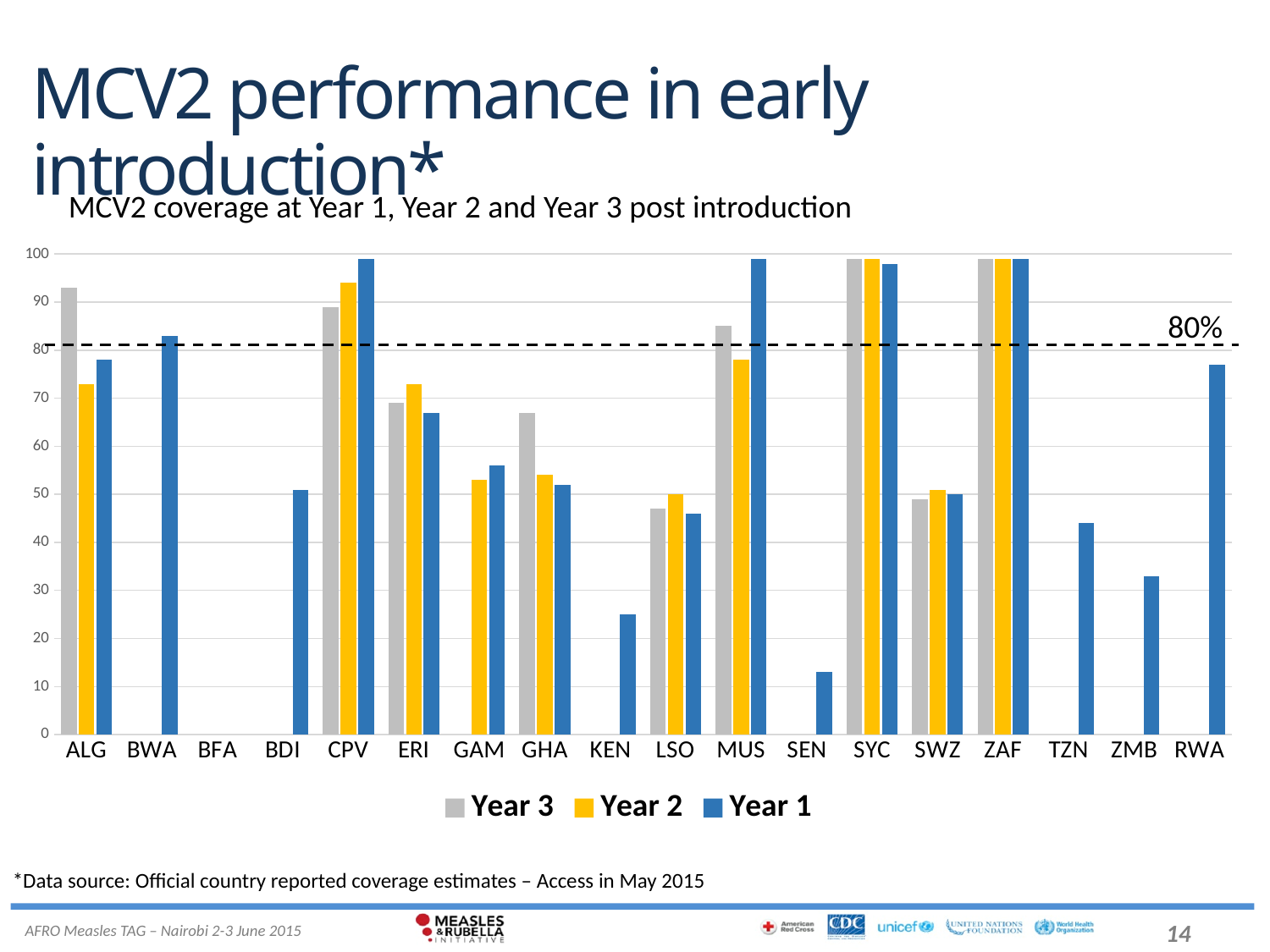
How many series does the legend list? 3 Is the Year 1 value for CPV greater or less than 90? greater For ALG, which is larger: the Year 3 value or the Year 2 value? Year 3 What value does the dashed horizontal line mark? 80% Is the Year 1 value for SEN greater or less than 20? less What kind of chart is shown on the slide? bar chart Is the Year 3 value for ALG greater or less than 90? greater How many countries are shown on the x axis? 18 Which colour represents Year 1 in the legend? blue Which country has the lowest Year 1 value? SEN